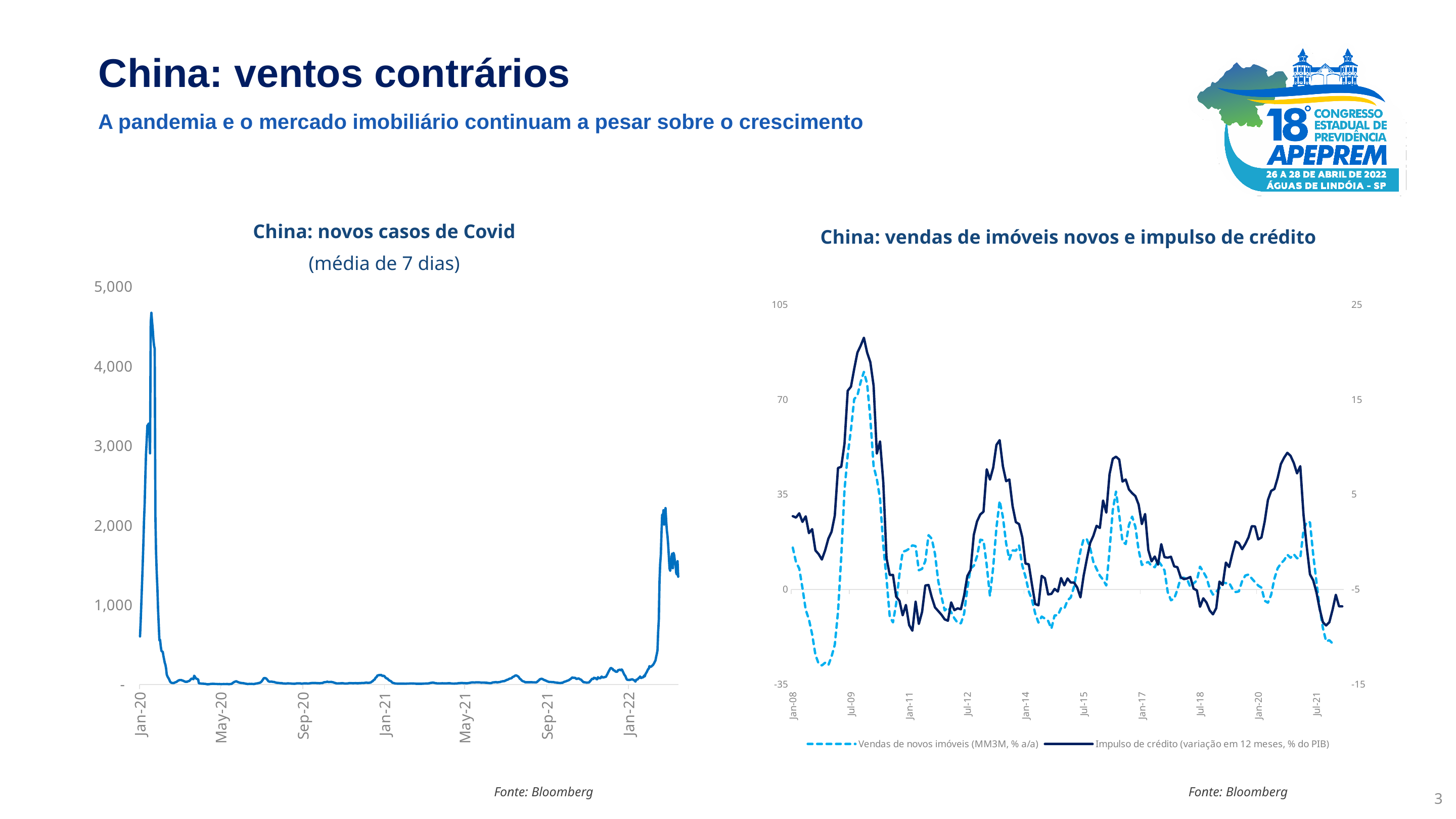
What is the subtitle shown under the title 'China: novos casos de Covid'? (média de 7 dias) In 'China: novos casos de Covid', is the value at May-21 greater or less than 1,000? less In 'China: novos casos de Covid', do new cases rise or fall between the early-2020 peak and May-20? fall In 'China: vendas de imóveis novos e impulso de crédito', does the 'Impulso de crédito' line rise or fall between Jan-20 and Jul-21? fall In 'China: novos casos de Covid', is the value at Sep-20 greater or less than 1,000? less In 'China: vendas de imóveis novos e impulso de crédito', which series is drawn as a dashed line? Vendas de novos imóveis (MM3M, % a/a) In 'China: novos casos de Covid', do new cases rise or fall between Sep-21 and Jan-22? rise In 'China: novos casos de Covid', is the peak value in early 2020 greater or less than 4,000? greater What kind of chart is 'China: vendas de imóveis novos e impulso de crédito'? line chart What kind of chart is 'China: novos casos de Covid'? line chart How many series does the legend of 'China: vendas de imóveis novos e impulso de crédito' list? 2